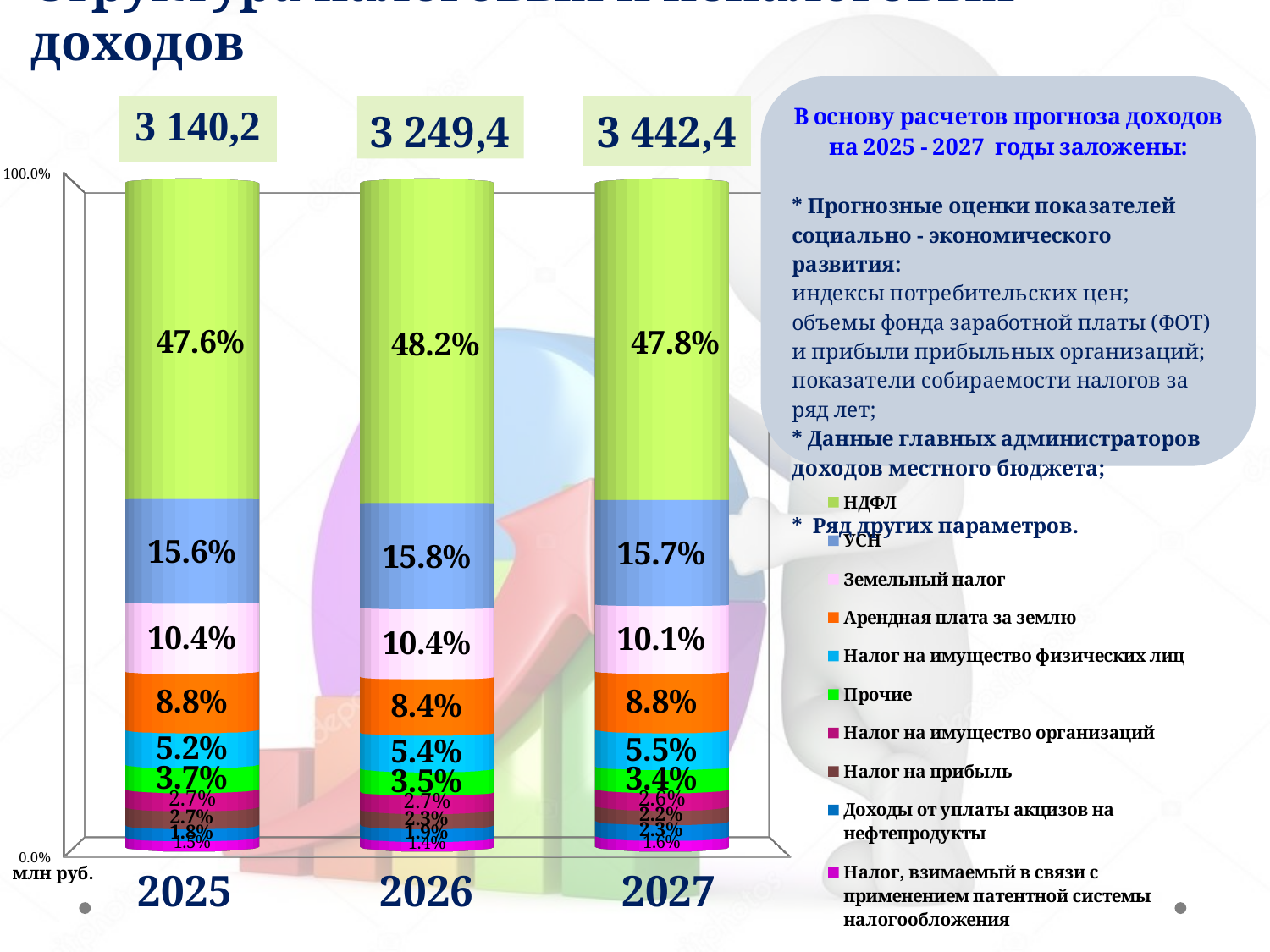
In which year is the НДФЛ share the highest? 2026 What is the difference between the НДФЛ share in 2026 and in 2025? 0.6% How many series does the legend list? 10 How many years (bars) are shown on the chart? 3 What share does Арендная плата за землю have in the 2026 bar? 8.4% What share does УСН have in the 2027 bar? 15.7% What total value (млн руб.) is shown above the 2027 bar? 3 442,4 What share does НДФЛ have in the 2025 bar? 47.6% Which is larger: the Прочие share in 2025 or in 2027? 2025 What share does Налог на имущество физических лиц have in the 2027 bar? 5.5% What kind of chart is shown on the slide? Stacked bar chart What share does Земельный налог have in the 2026 bar? 10.4%